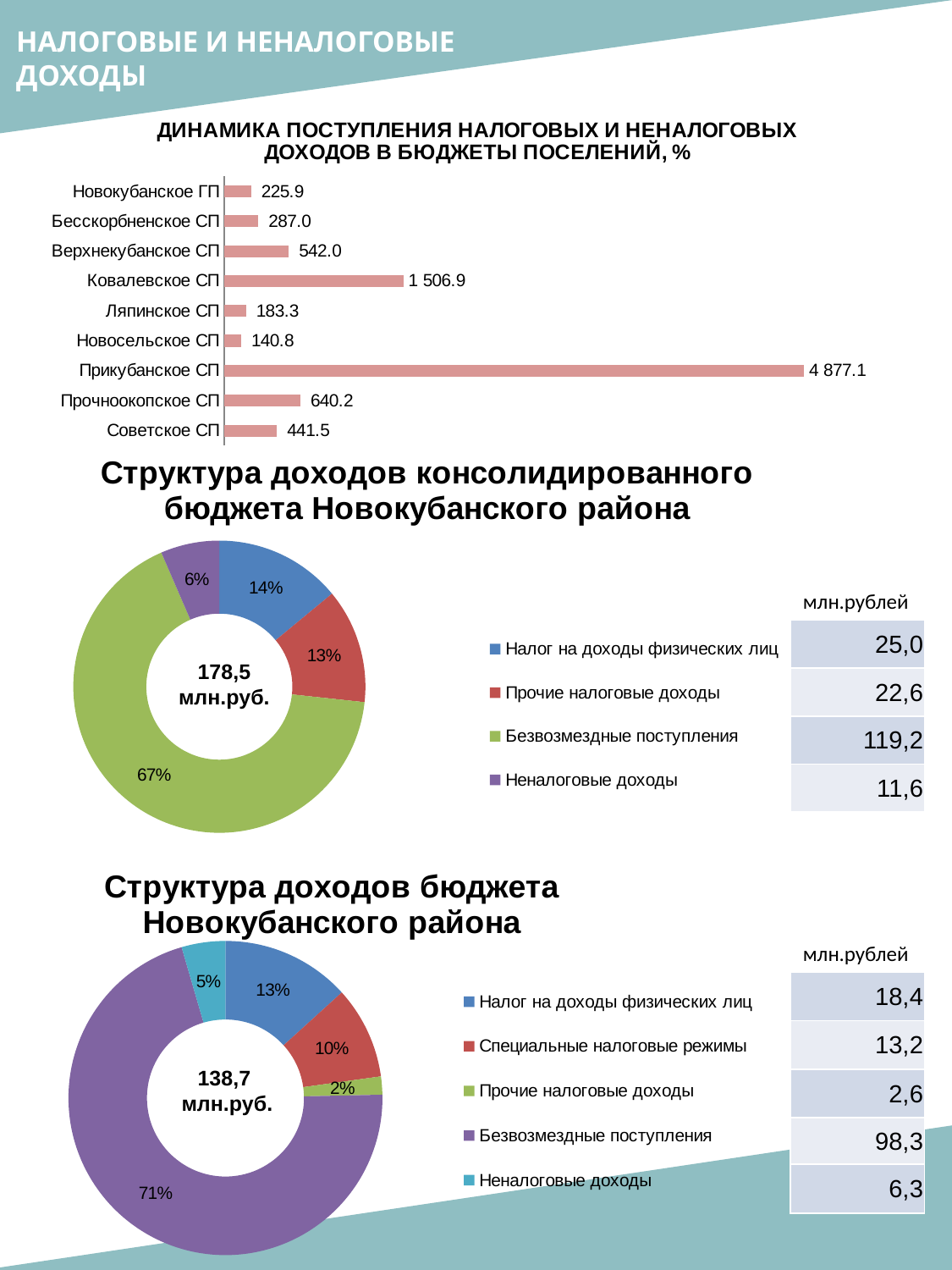
How many settlements are shown in the bar chart 'Динамика поступления налоговых и неналоговых доходов в бюджеты поселений, %'? 9 How many categories does the legend of the chart 'Структура доходов бюджета Новокубанского района' list? 5 In the bar chart 'Динамика поступления налоговых и неналоговых доходов в бюджеты поселений, %', which is larger: Верхнекубанское СП or Бесскорбненское СП? Верхнекубанское СП In the chart 'Структура доходов консолидированного бюджета Новокубанского района', what share do Безвозмездные поступления make up? 67% In the bar chart 'Динамика поступления налоговых и неналоговых доходов в бюджеты поселений, %', which settlement has the highest value? Прикубанское СП In the bar chart 'Динамика поступления налоговых и неналоговых доходов в бюджеты поселений, %', what is the value for Ковалевское СП? 1 506.9 In the chart 'Структура доходов бюджета Новокубанского района', which category has the smallest share? Прочие налоговые доходы In the bar chart 'Динамика поступления налоговых и неналоговых доходов в бюджеты поселений, %', which settlement has the lowest value? Новосельское СП In the bar chart 'Динамика поступления налоговых и неналоговых доходов в бюджеты поселений, %', what is the difference between Прочноокопское СП and Советское СП? 198.7 What type of chart is 'Динамика поступления налоговых и неналоговых доходов в бюджеты поселений, %'? Bar chart What total is shown in the centre of the chart 'Структура доходов консолидированного бюджета Новокубанского района'? 178,5 млн.руб. In the chart 'Структура доходов консолидированного бюджета Новокубанского района', what is the value in млн.рублей for Налог на доходы физических лиц? 25,0